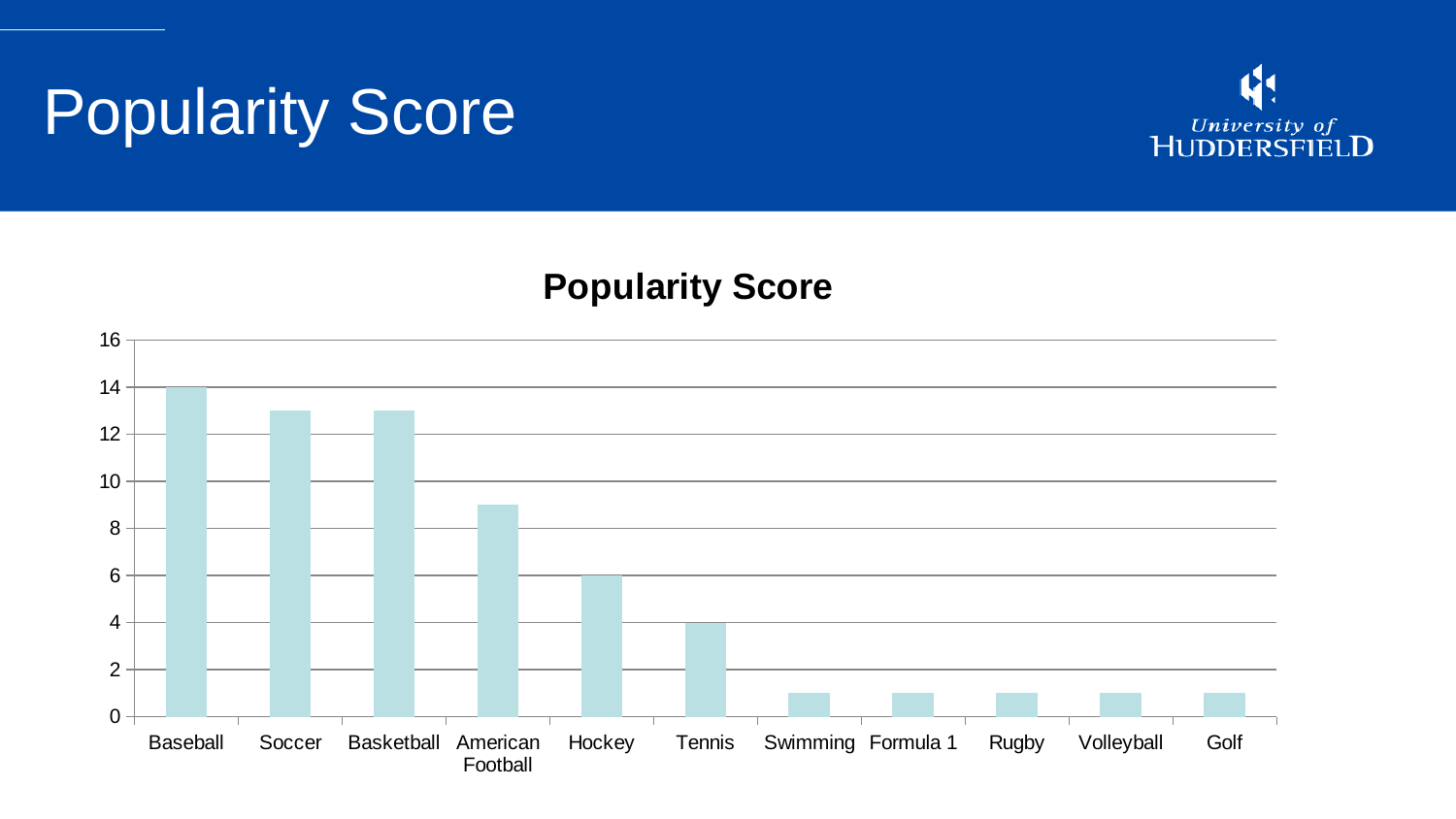
Is the value for American Football greater or less than 10? less What is the title of the chart? Popularity Score How many sports are shown on the x axis of the chart? 11 What is the popularity score for Hockey? 6 Is the value for Soccer greater or less than 12? greater Which sport has the highest popularity score? Baseball What is the popularity score for Baseball? 14 Do the values generally rise or fall moving from left to right along the x axis? fall What type of chart is shown on the slide? bar chart Is the value for Swimming greater or less than 2? less Which has a higher popularity score, Hockey or Tennis? Hockey What is the popularity score for Tennis? 4